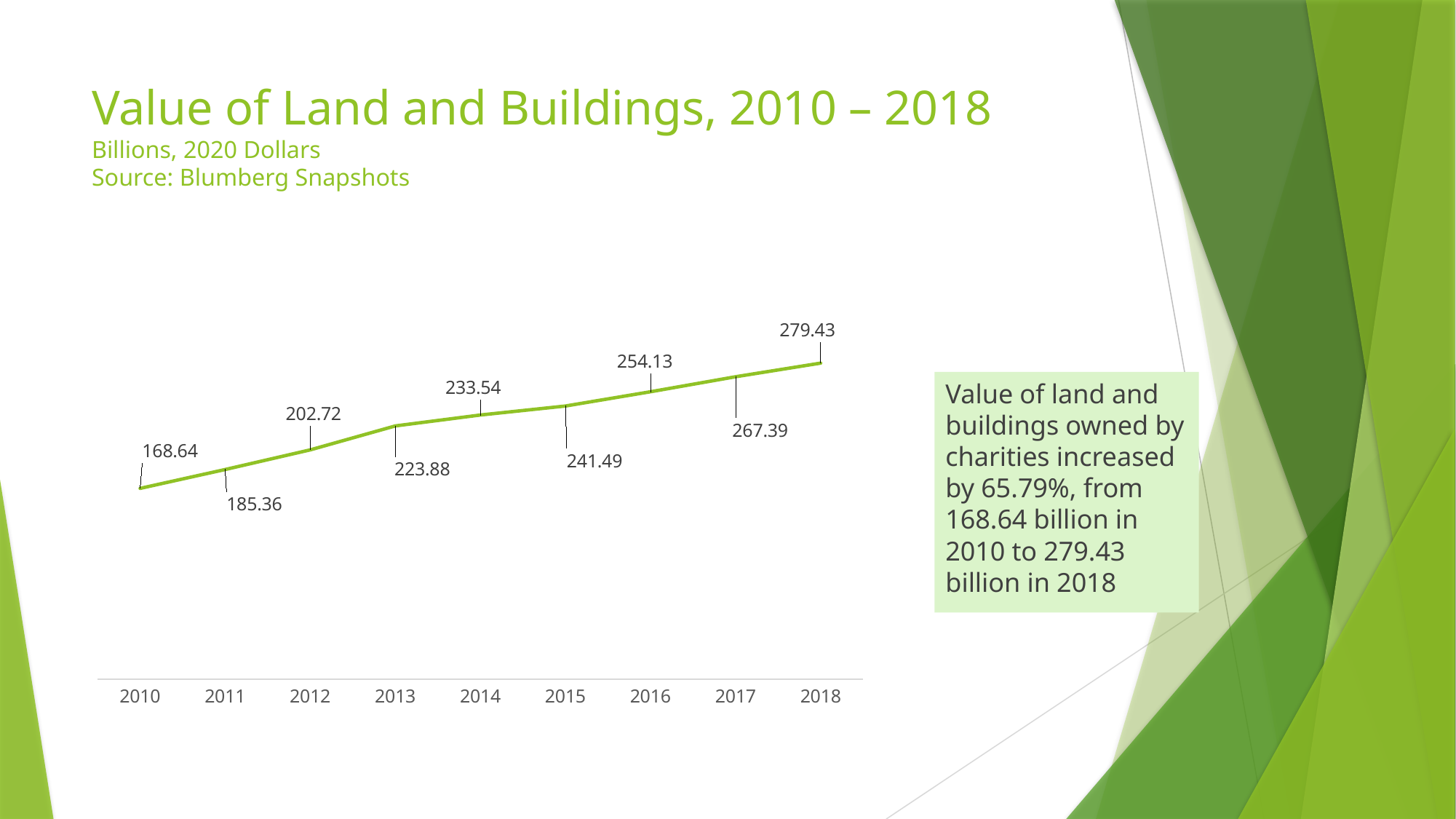
What is the value of land and buildings in 2017? 267.39 Which is larger, the value in 2015 or the value in 2016? 2016 What is the value of land and buildings in 2011? 185.36 Which year has the lowest value of land and buildings? 2010 What is the title of the chart on the slide? Value of Land and Buildings, 2010 – 2018 What kind of chart is shown on the slide? line chart How many years are plotted on the chart? 9 Do the values rise or fall from 2010 to 2018? rise What is the difference between the value in 2013 and the value in 2012? 21.16 What is the difference between the value in 2018 and the value in 2010? 110.79 Which year has the highest value of land and buildings? 2018 What is the value of land and buildings in 2014? 233.54